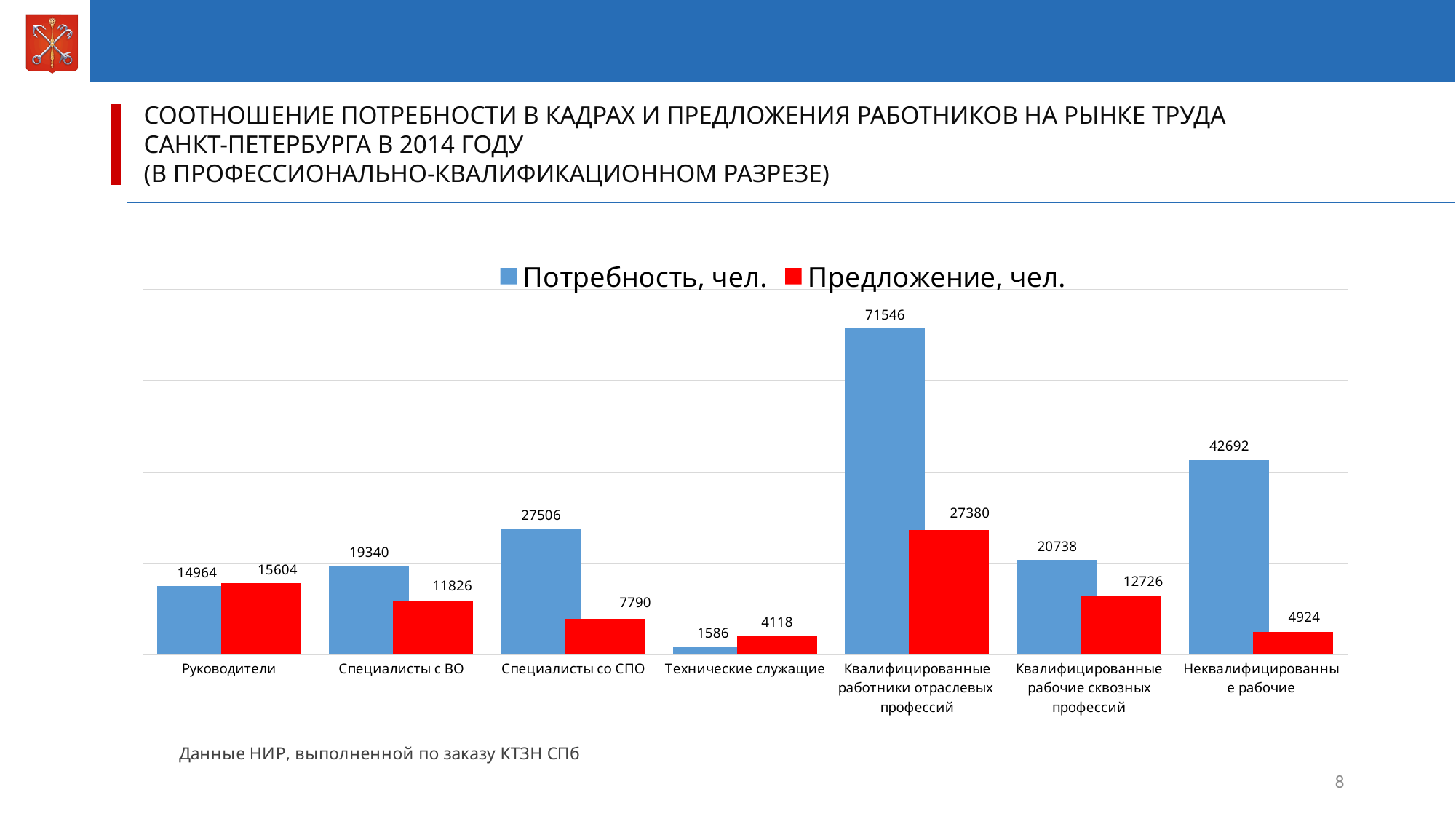
What is the value of Предложение, чел. for Специалисты со СПО? 7790 How many series does the chart legend list? 2 What type of chart is shown on the slide? Bar chart What is the value of Потребность, чел. for Неквалифицированные рабочие? 42692 What is the difference between Потребность, чел. and Предложение, чел. for Квалифицированные работники отраслевых профессий? 44166 Which is larger for Руководители: Потребность, чел. or Предложение, чел.? Предложение, чел. What colour represents the series Предложение, чел. in the chart? Red Which category has the highest value of Потребность, чел.? Квалифицированные работники отраслевых профессий Which category has the lowest value of Предложение, чел.? Технические служащие Which is larger for Технические служащие: Потребность, чел. or Предложение, чел.? Предложение, чел. How many categories are shown on the x axis of the chart? 7 What is the value of Потребность, чел. for Руководители? 14964